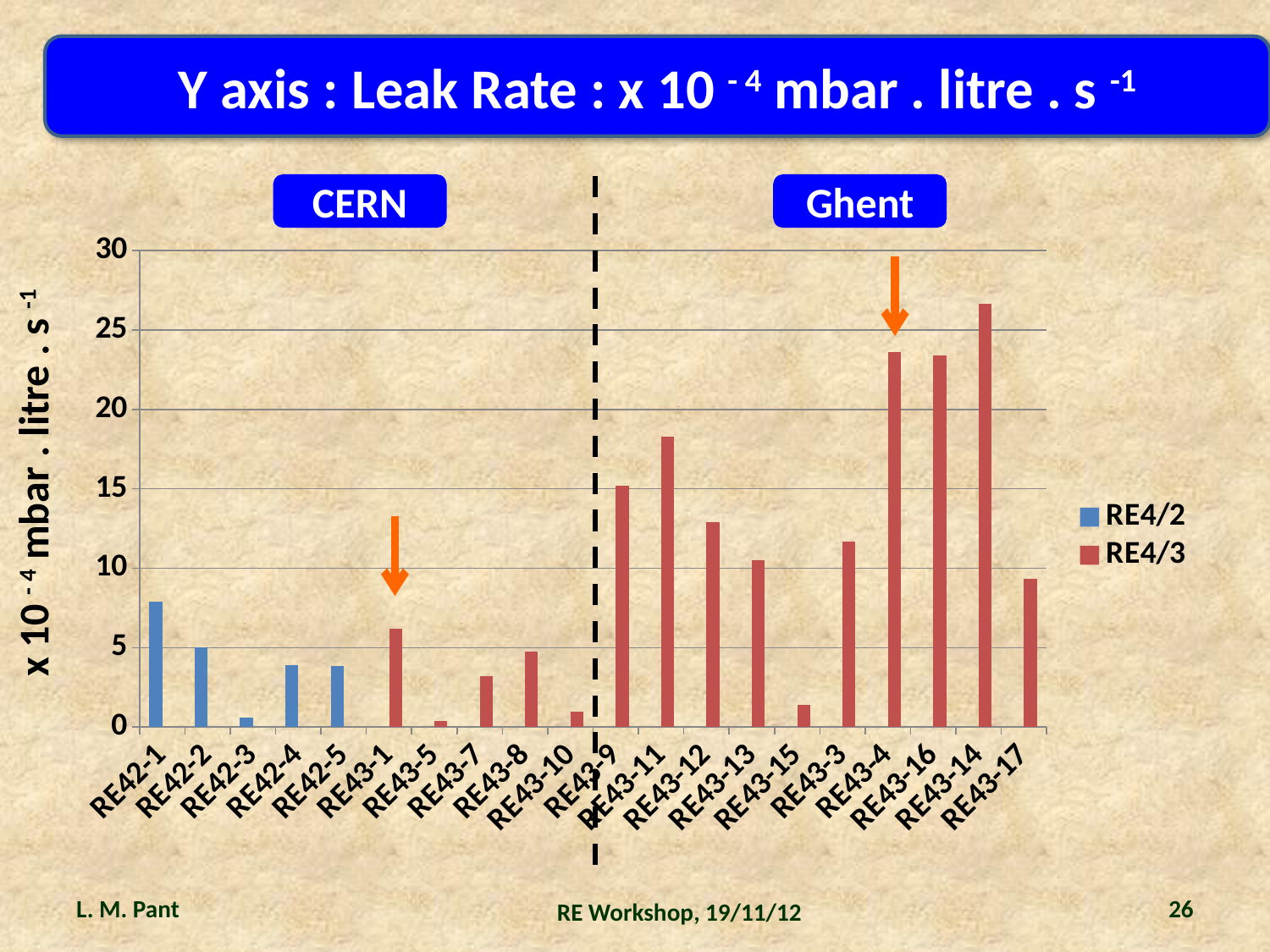
How many chambers (categories) are plotted along the x axis? 20 Is the value for RE43-15 greater or less than 5? less Is the value for RE42-1 greater or less than 5? greater Which chamber has the highest leak rate? RE43-14 How many series does the legend list? 2 Which has the larger leak rate, RE43-11 or RE43-12? RE43-11 What are the two series named in the legend? RE4/2 and RE4/3 What kind of chart is shown on the slide? bar chart Is the value for RE43-14 greater or less than 25? greater Which has the larger leak rate, RE42-1 or RE42-2? RE42-1